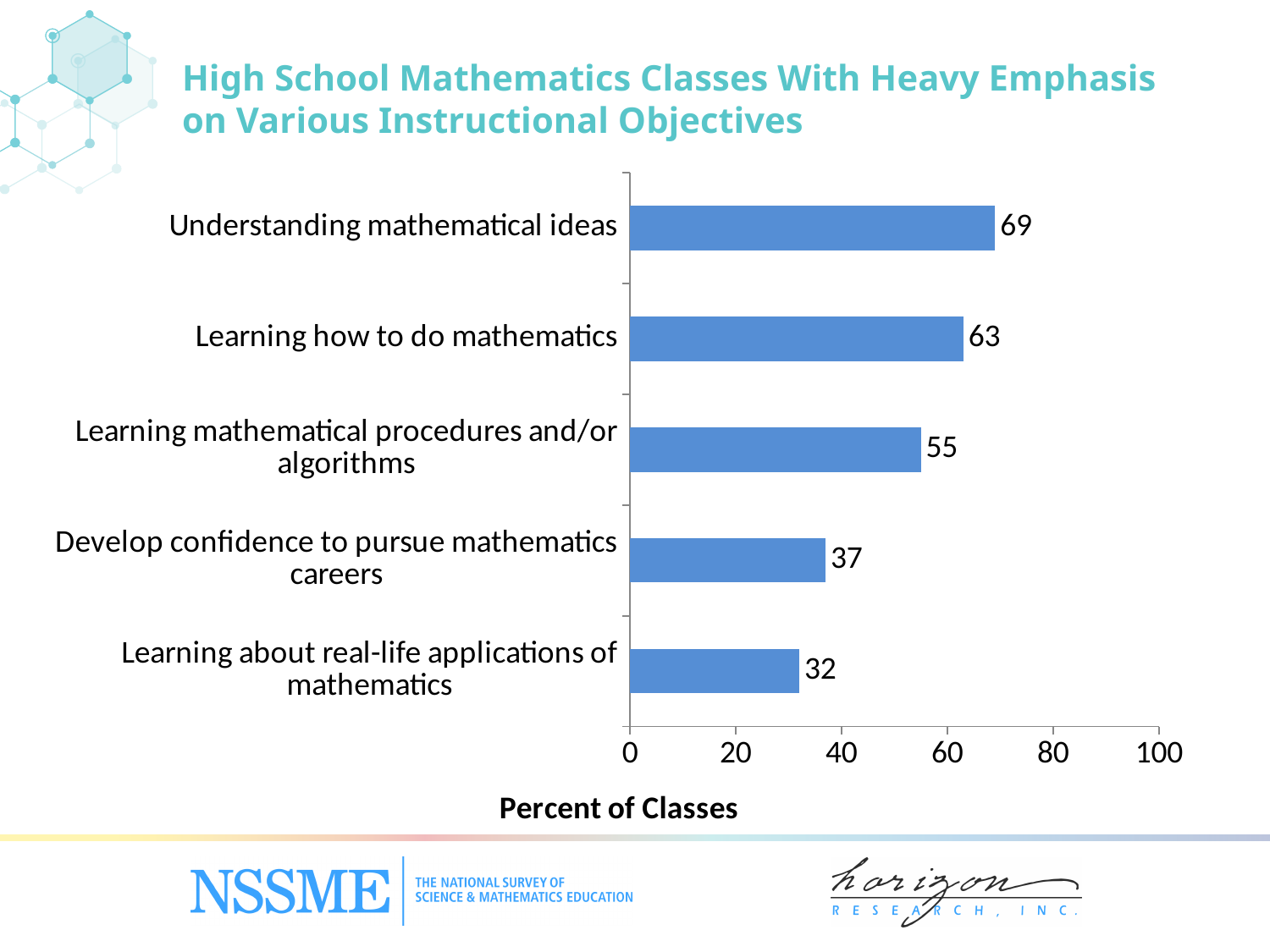
What is the label of the horizontal axis? Percent of Classes How many instructional objectives are shown in the chart? 5 What is the difference between the values for learning mathematical procedures and/or algorithms and learning about real-life applications of mathematics? 23 What is the value for developing confidence to pursue mathematics careers? 37 What is the difference between the values for understanding mathematical ideas and learning how to do mathematics? 6 Is the value for developing confidence to pursue mathematics careers greater or less than 40? less Which instructional objective has the lowest percent of classes? Learning about real-life applications of mathematics Which instructional objective has the highest percent of classes? Understanding mathematical ideas What kind of chart is shown on the slide? Bar chart What is the value for learning about real-life applications of mathematics? 32 What percent of classes place heavy emphasis on understanding mathematical ideas? 69 Which is larger: the value for learning how to do mathematics or the value for learning mathematical procedures and/or algorithms? Learning how to do mathematics